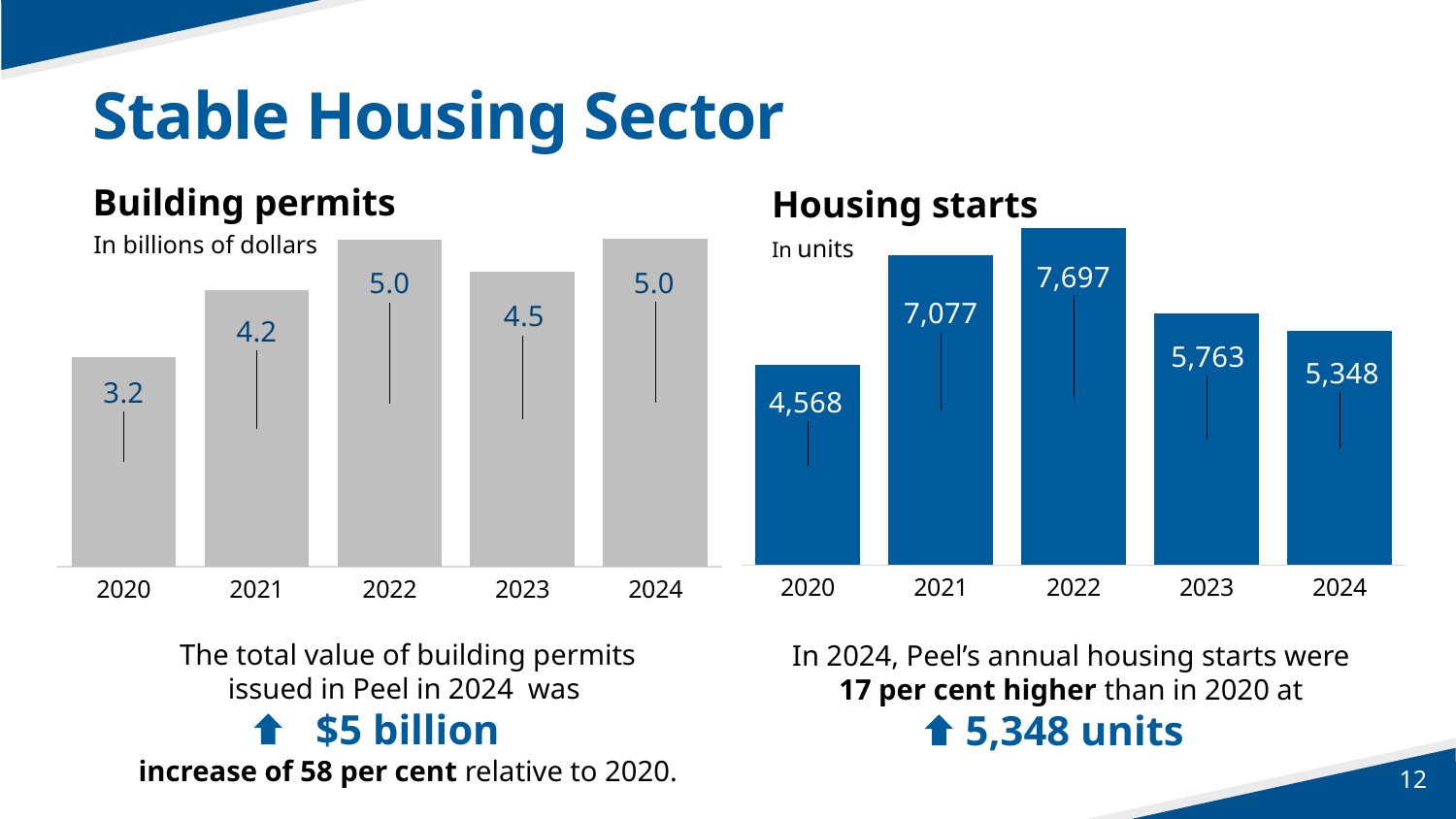
In the Housing starts chart, which year has the highest value? 2022 In the Housing starts chart, how many housing starts were there in 2024? 5,348 In the Building permits chart, which is larger, the value for 2021 or the value for 2023? 2023 In the Building permits chart, what was the value for 2023? 4.5 What type of chart is the Building permits chart? Bar chart In the Housing starts chart, what is the difference between the 2022 value and the 2023 value? 1,934 In the Housing starts chart, how many housing starts were there in 2021? 7,077 In the Housing starts chart, which year has the lowest value? 2020 In the Building permits chart, what is the difference between the 2024 value and the 2020 value? 1.8 In the Building permits chart, which year has the lowest value? 2020 In the Building permits chart, what was the value for 2020? 3.2 How many years are shown in the Housing starts chart? 5